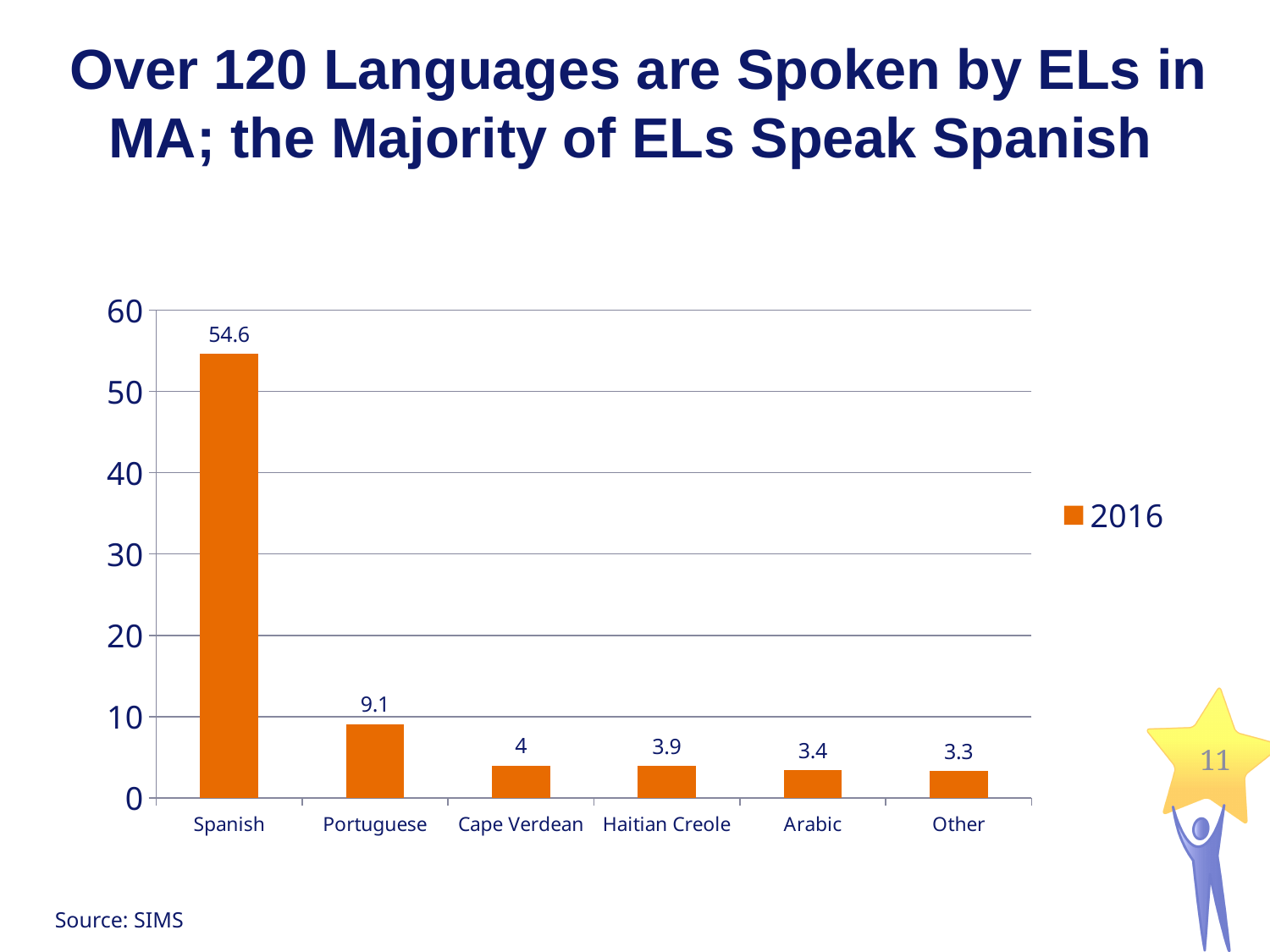
What is the value for Haitian Creole? 3.9 Which is larger, the value for Cape Verdean or the value for Arabic? Cape Verdean What is the value for Portuguese? 9.1 What is the difference between the values for Spanish and Portuguese? 45.5 Is the value for Portuguese greater or less than 10? less How many categories are shown on the x axis? 6 What is the value for Arabic? 3.4 What kind of chart is shown on the slide? bar chart Which category has the highest value? Spanish Which category has the lowest value? Other How many series does the legend list? 1 What is the value for Spanish? 54.6